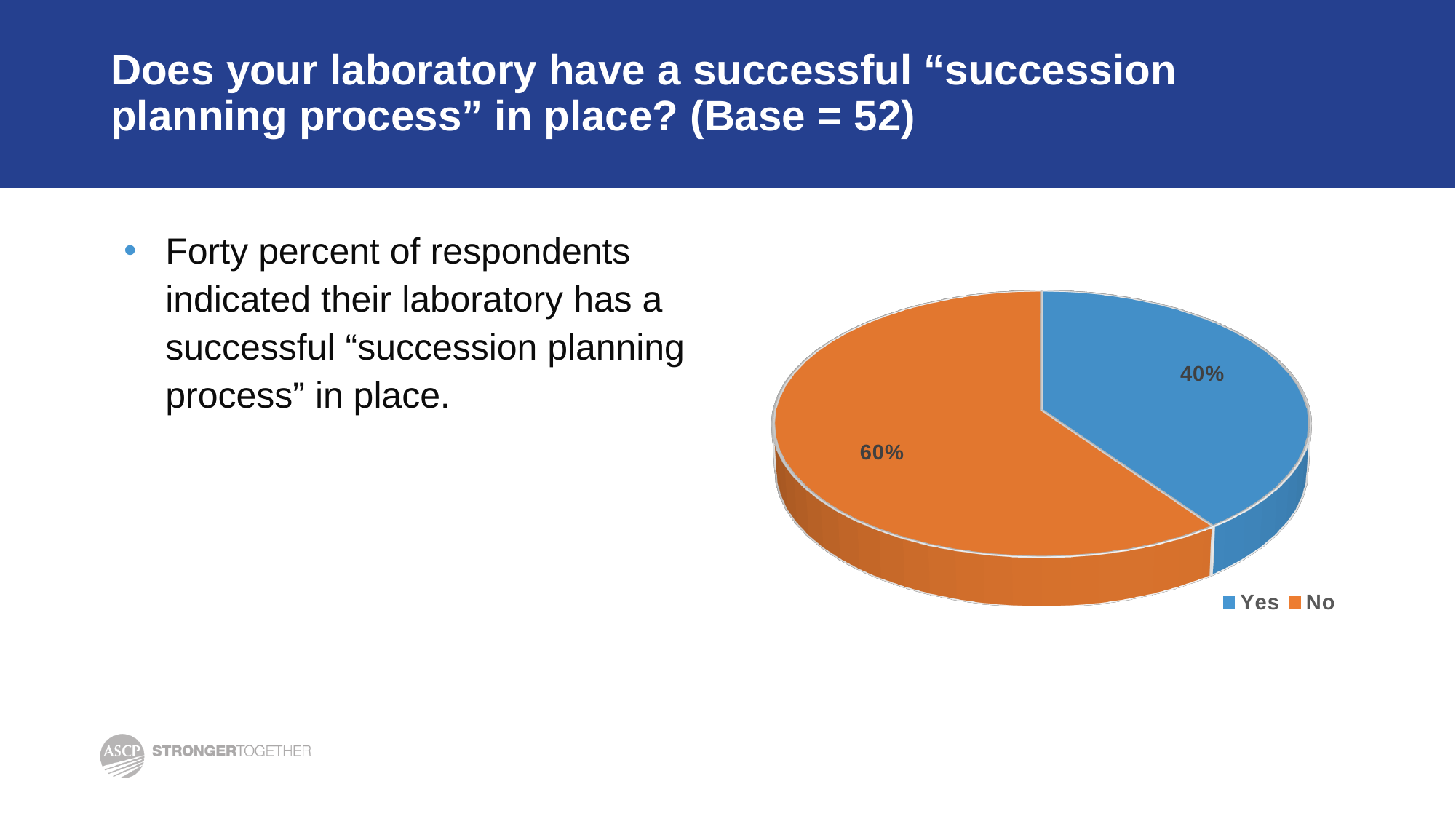
What colour is the "Yes" slice? blue What percentage of respondents answered "Yes"? 40% What is the difference in percentage points between the "No" and "Yes" slices? 20 What percentage of respondents answered "No"? 60% How many slices does the pie chart have? 2 What colour is the "No" slice? orange Which response has the largest share of the pie? No What share of the pie does the "No" slice represent? 60% How many entries does the legend list? 2 What kind of chart is shown on the slide? pie chart Which response has the smallest share of the pie? Yes Which slice is larger, "Yes" or "No"? No